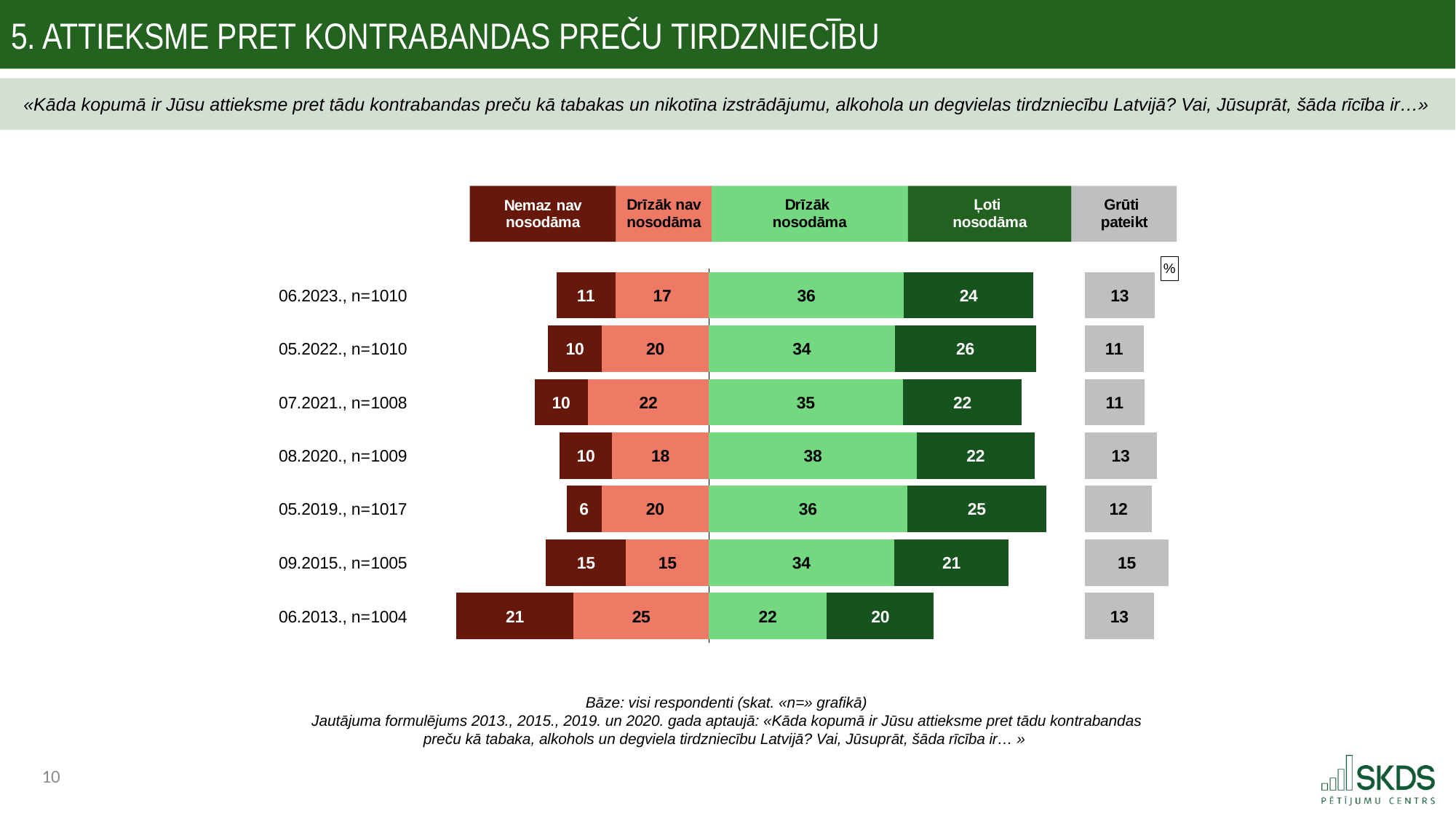
In which survey wave is the "Nemaz nav nosodāma" value the lowest? 05.2019., n=1017 What is the value for "Grūti pateikt" in the 09.2015., n=1005 row? 15 In which survey wave is the "Drīzāk nosodāma" value the highest? 08.2020., n=1009 What is the value for "Nemaz nav nosodāma" in the 06.2013., n=1004 row? 21 What is the difference between the "Nemaz nav nosodāma" values for 06.2013., n=1004 and 06.2023., n=1010? 10 Which row has the larger "Ļoti nosodāma" value: 05.2022., n=1010 or 06.2013., n=1004? 05.2022., n=1010 What is the combined value of "Nemaz nav nosodāma" and "Drīzāk nav nosodāma" in the 06.2013., n=1004 row? 46 What is the value for "Drīzāk nosodāma" in the 06.2023., n=1010 row? 36 How many survey waves (rows) are shown in the chart? 7 What kind of chart is shown on the slide? Stacked horizontal bar chart How many response categories does the legend list? 5 What colour is used for the "Ļoti nosodāma" category in the legend? Dark green